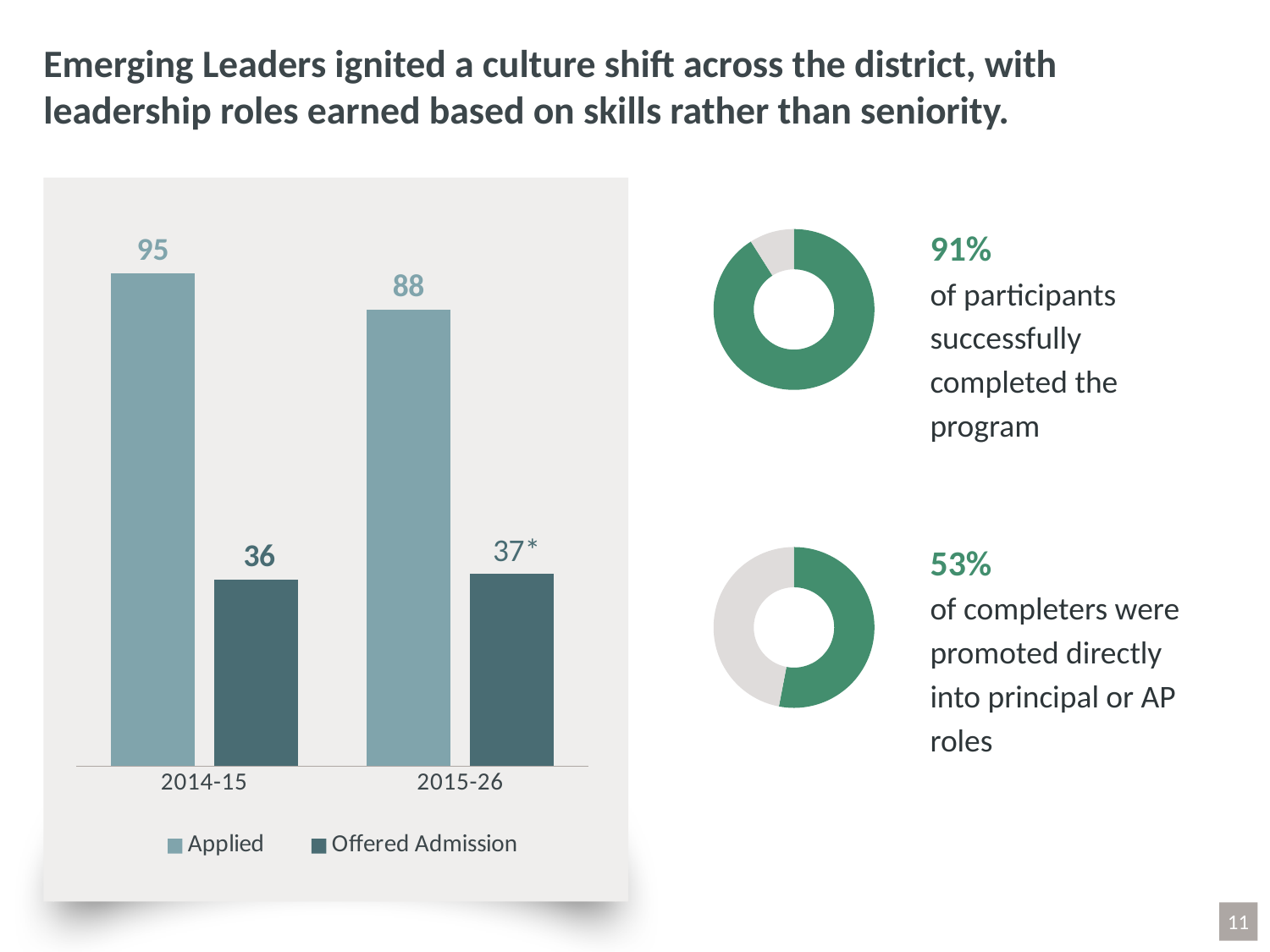
In the bar chart on the left, how many more applied in 2014-15 than in 2015-26? 7 In the bar chart on the left, how many applied in 2014-15? 95 In the bar chart on the left, which is larger: Applied in 2015-26 or Offered Admission in 2015-26? Applied in 2015-26 In the bar chart on the left, which year had the higher number of applicants? 2014-15 In the bar chart on the left, what is the difference between Applied and Offered Admission in 2014-15? 59 In the bar chart on the left, how many were offered admission in 2014-15? 36 What type of chart is shown on the left of the slide? Bar chart How many year categories are shown on the x axis of the bar chart on the left? 2 In the top donut chart on the right, what share of participants successfully completed the program? 91% In the bar chart on the left, how many applied in 2015-26? 88 How many series does the legend of the bar chart on the left list? 2 In the bar chart on the left, what is the Offered Admission value for 2015-26? 37*